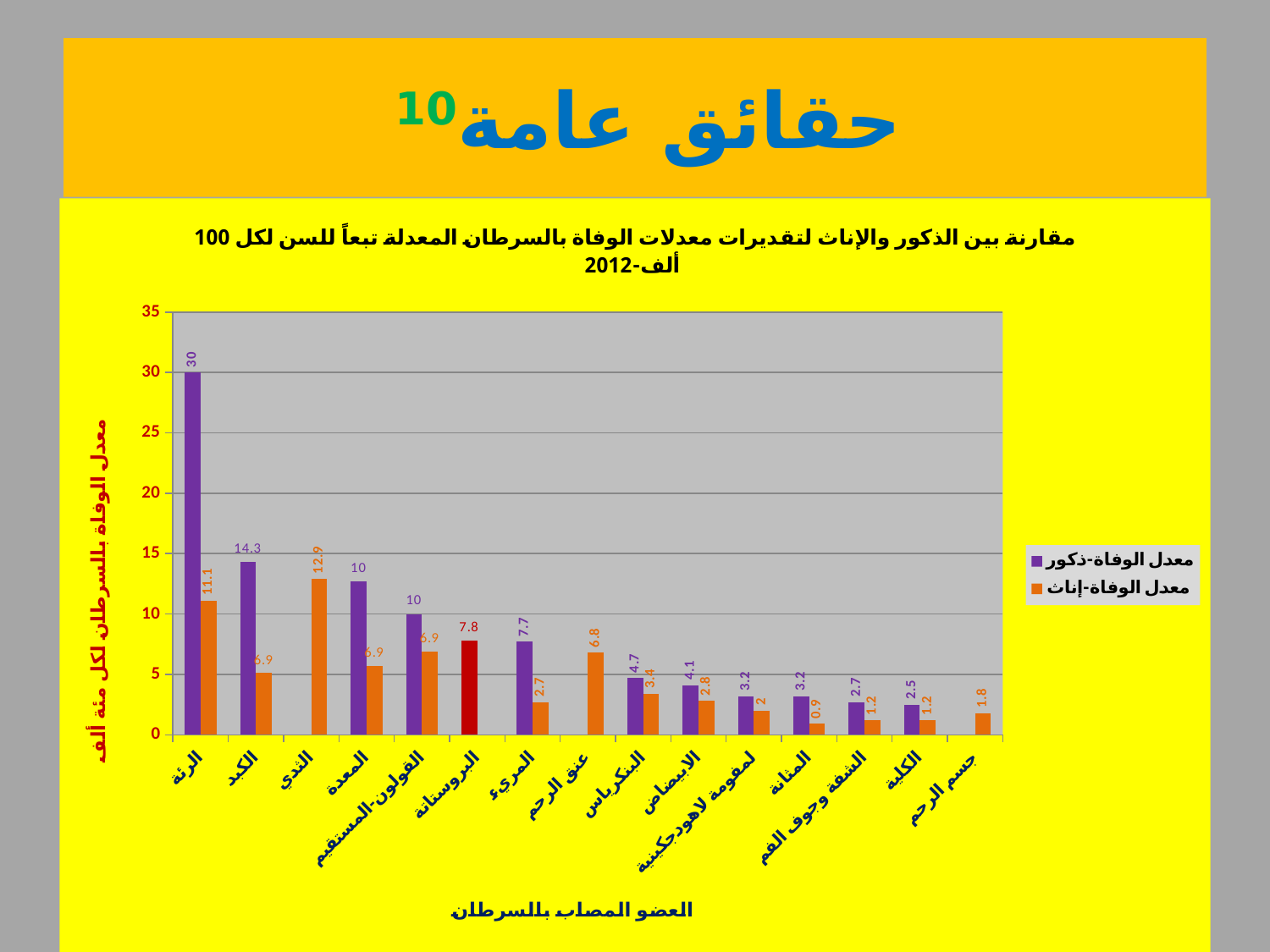
Which is larger: the male mortality rate for الكبد (liver) or for المعدة (stomach)? الكبد What is the difference between the male and female mortality rates for الرئة (lung)? 18.9 What value is shown for البروستاتة (prostate)? 7.8 How many series does the legend list? 2 What is the female mortality rate for عنق الرحم (cervix)? 6.8 Which organ has the highest male mortality rate? الرئة What is the male mortality rate (معدل الوفاة-ذكور) for الرئة (lung)? 30 Which organ has the lowest female mortality rate among those with a female bar? المثانة What is the female mortality rate for الثدي (breast)? 12.9 What is the female mortality rate (معدل الوفاة-إناث) for الرئة (lung)? 11.1 How many organ categories are shown on the x axis? 15 Is the male mortality rate for الكبد (liver) greater or less than 10? greater